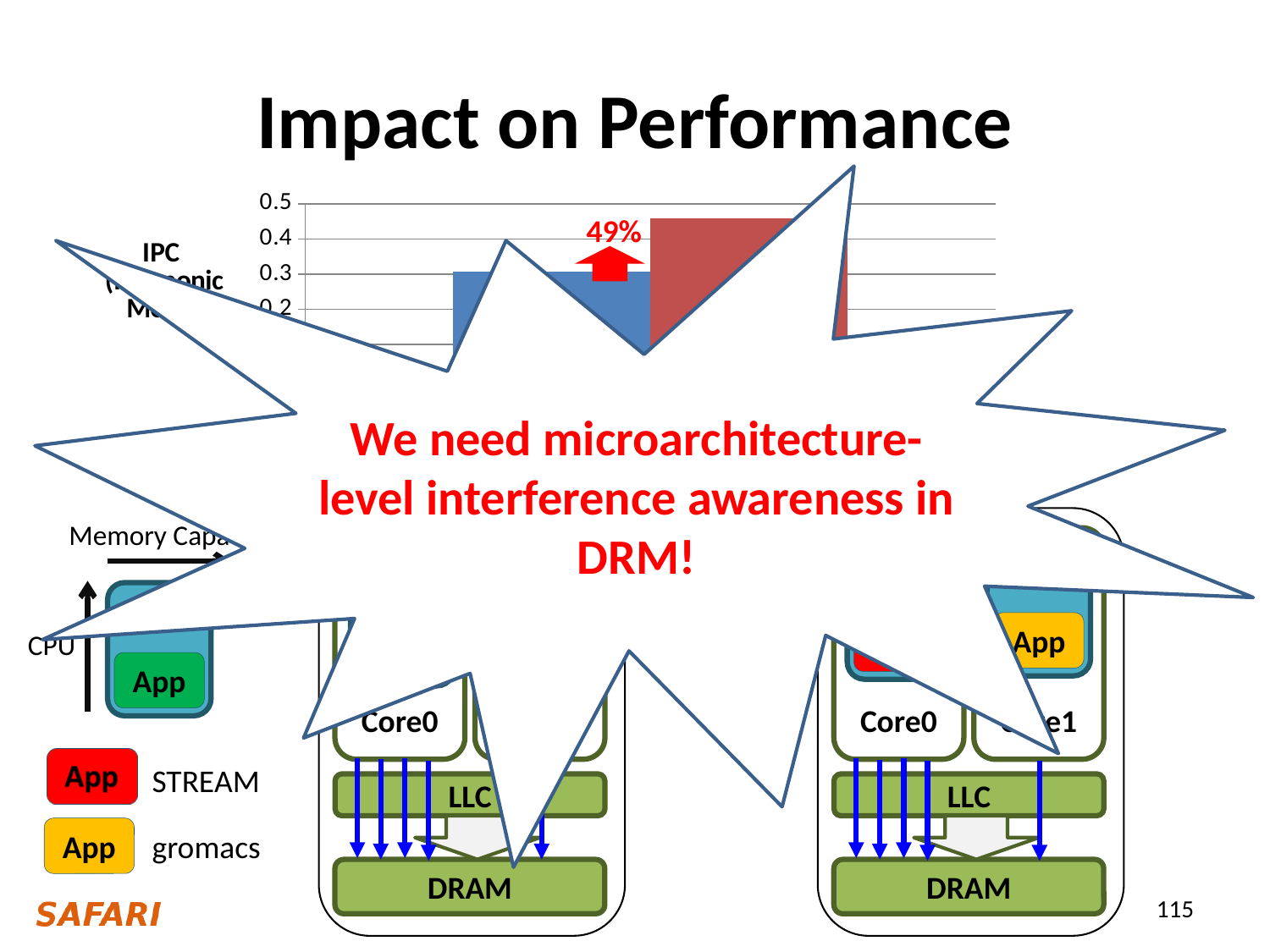
In the chart at the top of the slide, which bar is taller, the blue bar or the red bar? the red bar In the chart at the top of the slide, is the value of the blue bar greater or less than 0.4? less What is the highest value shown on the y axis of the chart at the top of the slide? 0.5 In the chart at the top of the slide, is the value of the red bar greater or less than 0.4? greater What percentage improvement is annotated with an arrow on the chart at the top of the slide? 49% What kind of chart is shown at the top of the slide? bar chart